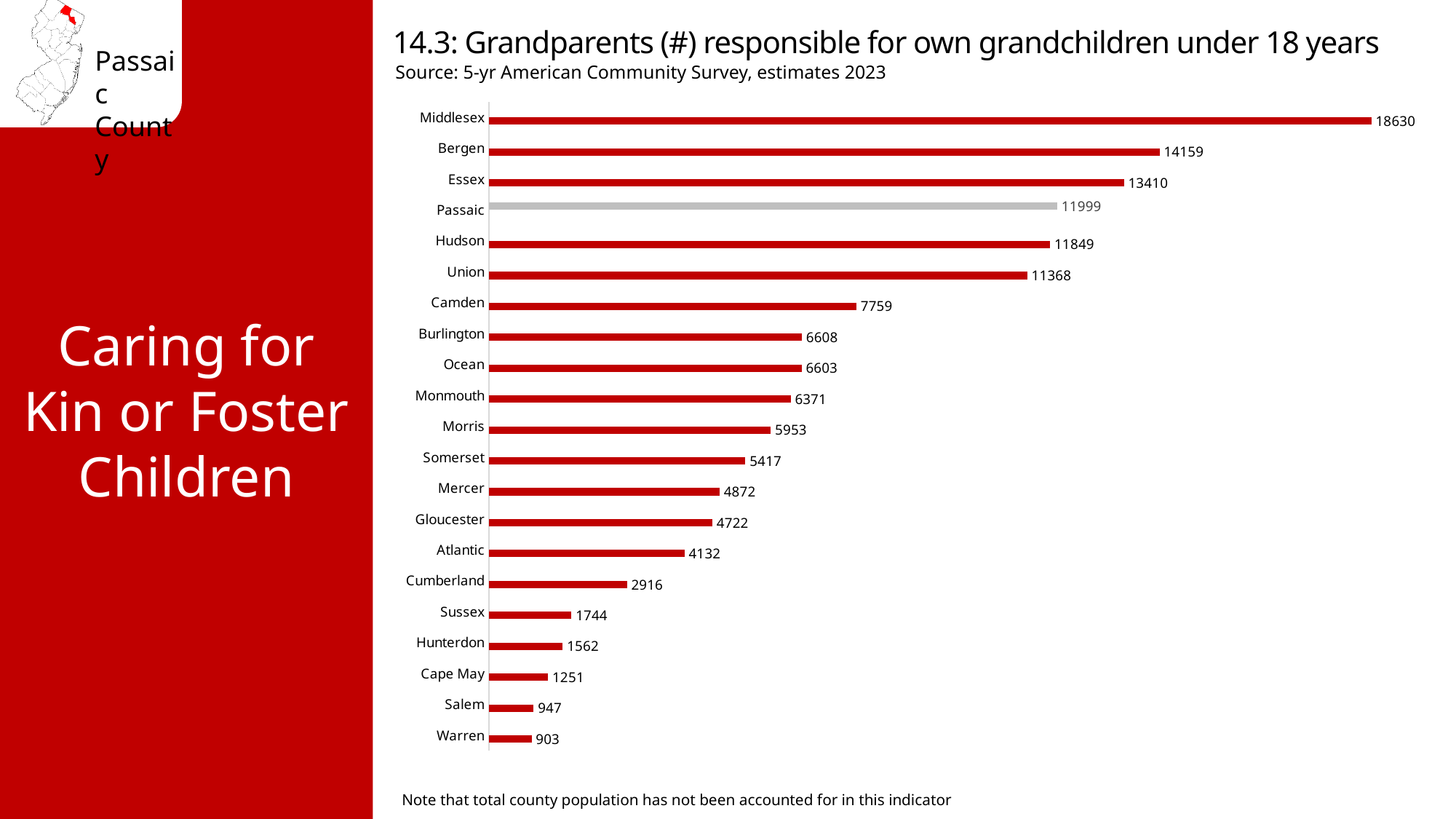
How many counties are shown in the chart? 21 What kind of chart is shown on the slide? Bar chart Which is larger, the value for Sussex or the value for Hunterdon? Sussex What is the value for Passaic? 11999 Which is larger, the value for Essex or the value for Union? Essex What is the difference between the values for Passaic and Hudson? 150 What is the difference between the values for Middlesex and Bergen? 4471 Which county has the highest value? Middlesex What is the value for Camden? 7759 Which county has the lowest value? Warren Which county's bar is shown in grey rather than red? Passaic What is the value for Cumberland? 2916